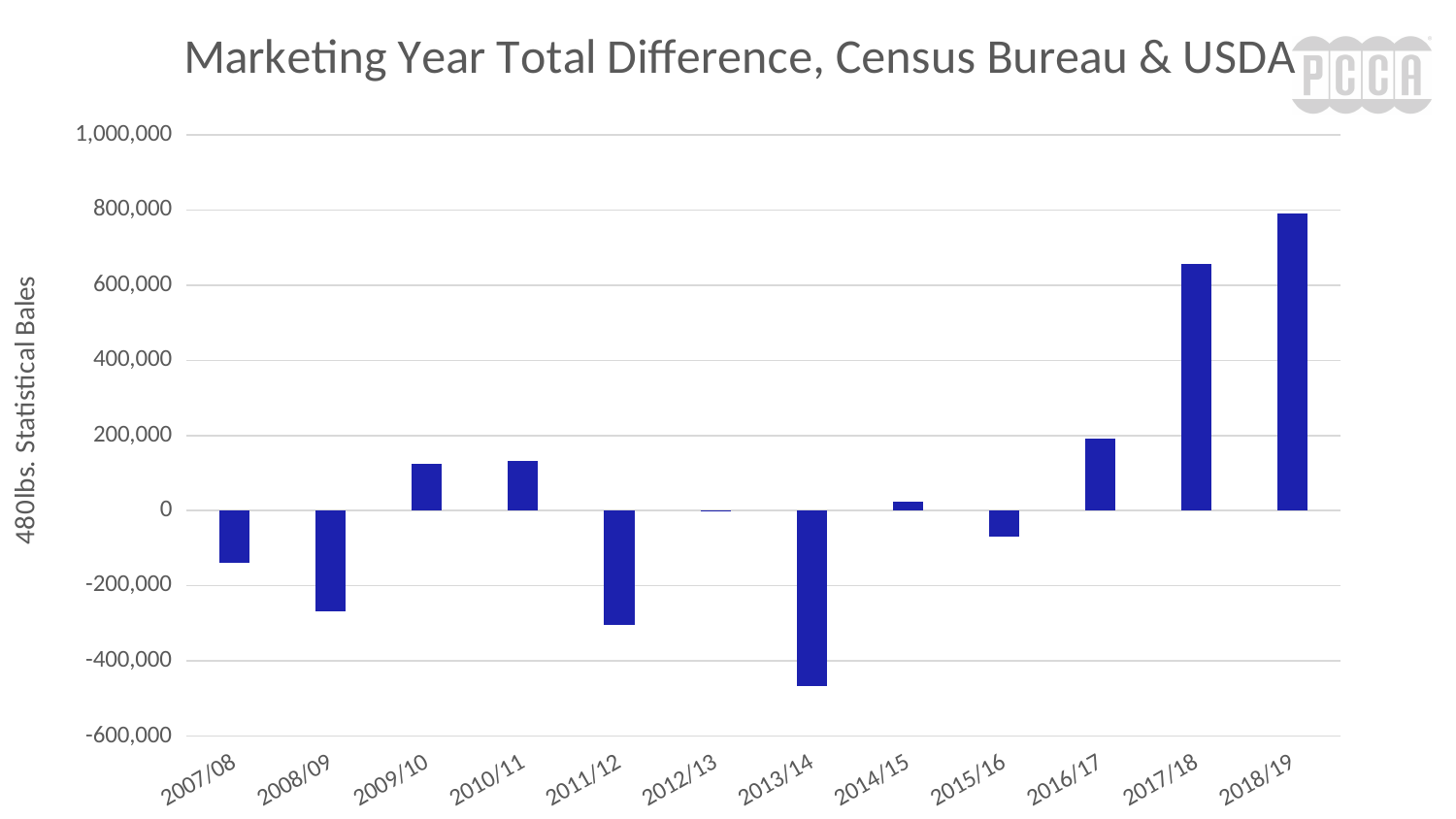
Which marketing year has the lowest value? 2013/14 What is the title of the chart? Marketing Year Total Difference, Census Bureau & USDA Which is larger, the value for 2007/08 or the value for 2008/09? 2007/08 What kind of chart is shown on the slide? bar chart How many marketing years are plotted on the chart? 12 What is the label on the vertical axis? 480lbs. Statistical Bales Is the value for 2017/18 greater or less than 600,000? greater Which marketing year has the highest value? 2018/19 Is the value for 2008/09 greater or less than -200,000? less Is the value for 2013/14 greater or less than -400,000? less Which is larger, the value for 2016/17 or the value for 2017/18? 2017/18